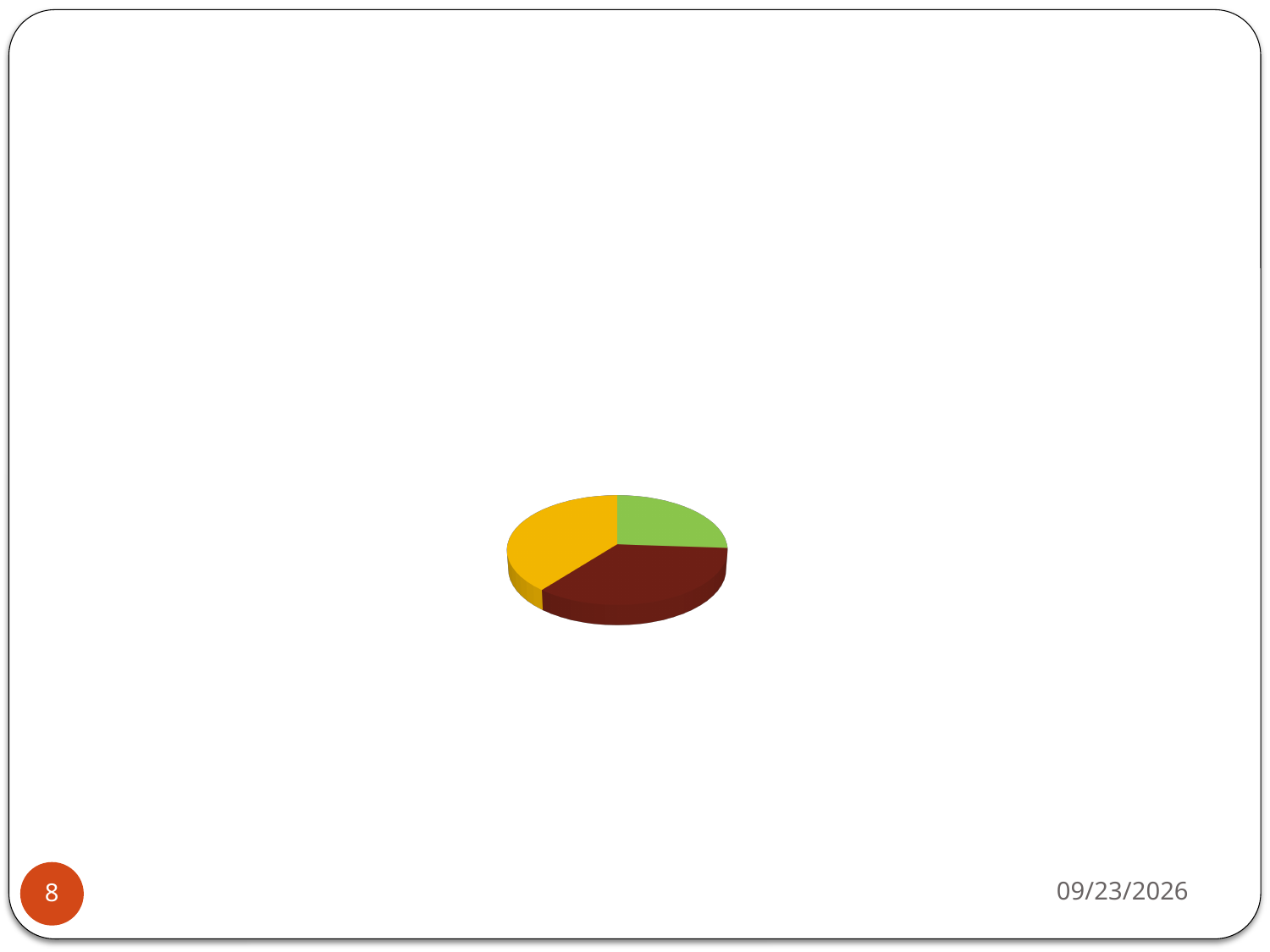
Does the pie chart have a legend? No What kind of chart is shown on the slide? pie chart Is the green slice or the yellow slice larger in the pie chart? yellow Which colour slice is the largest in the pie chart? dark red Does the pie chart show any data labels? No Which colour slice is the smallest in the pie chart? green How many slices does the pie chart have? 3